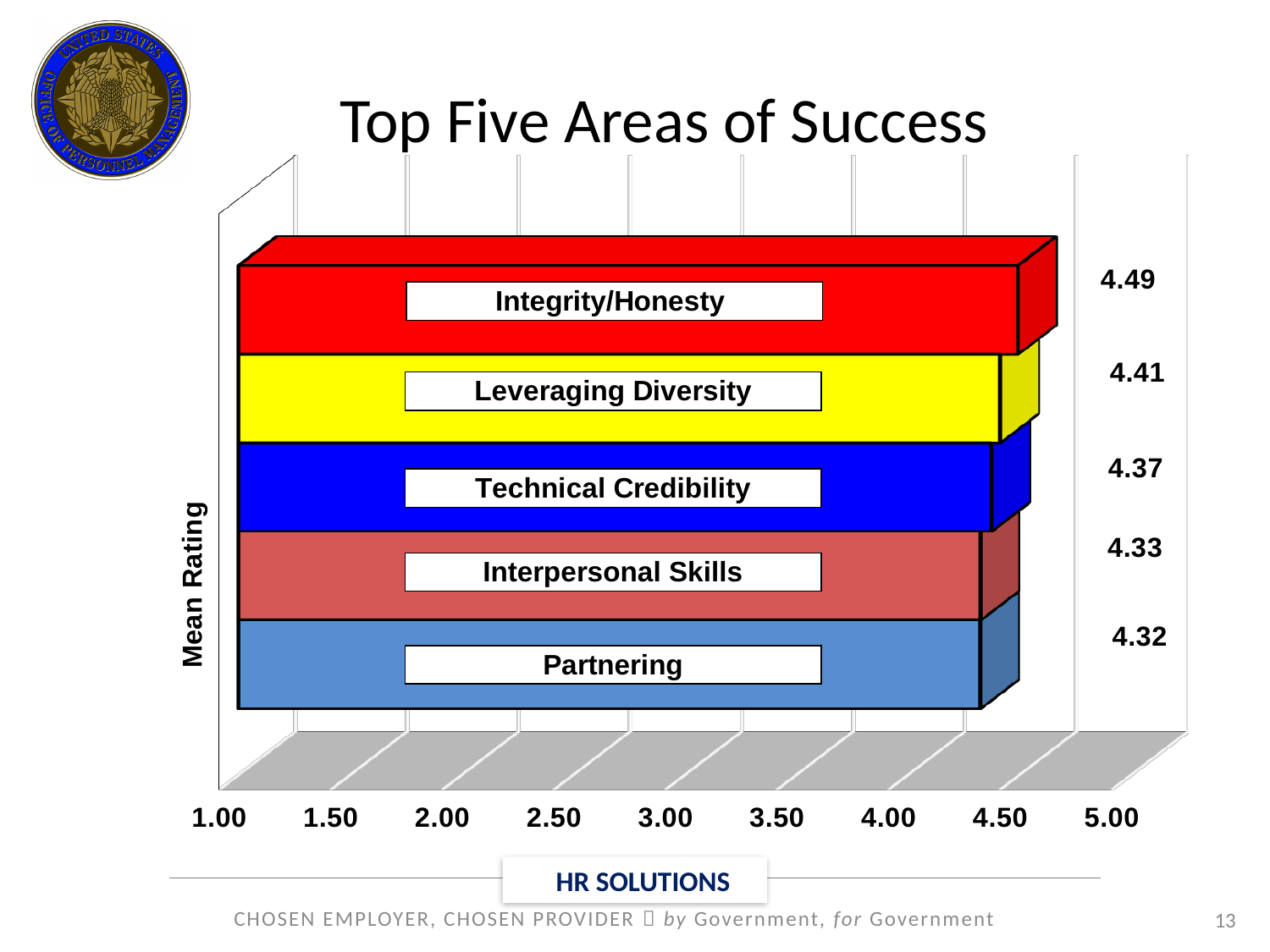
What is the mean rating for Integrity/Honesty? 4.49 Which has a higher mean rating, Leveraging Diversity or Technical Credibility? Leveraging Diversity Is the mean rating for Interpersonal Skills greater or less than 4.00? greater What is the title of the chart? Top Five Areas of Success What is the mean rating for Technical Credibility? 4.37 What is the mean rating for Partnering? 4.32 What is the difference between the mean ratings for Leveraging Diversity and Interpersonal Skills? 0.08 What is the difference between the mean ratings for Integrity/Honesty and Partnering? 0.17 How many areas are shown in the chart? 5 Which area has the lowest mean rating? Partnering Which area has the highest mean rating? Integrity/Honesty What kind of chart is shown on the slide? Bar chart